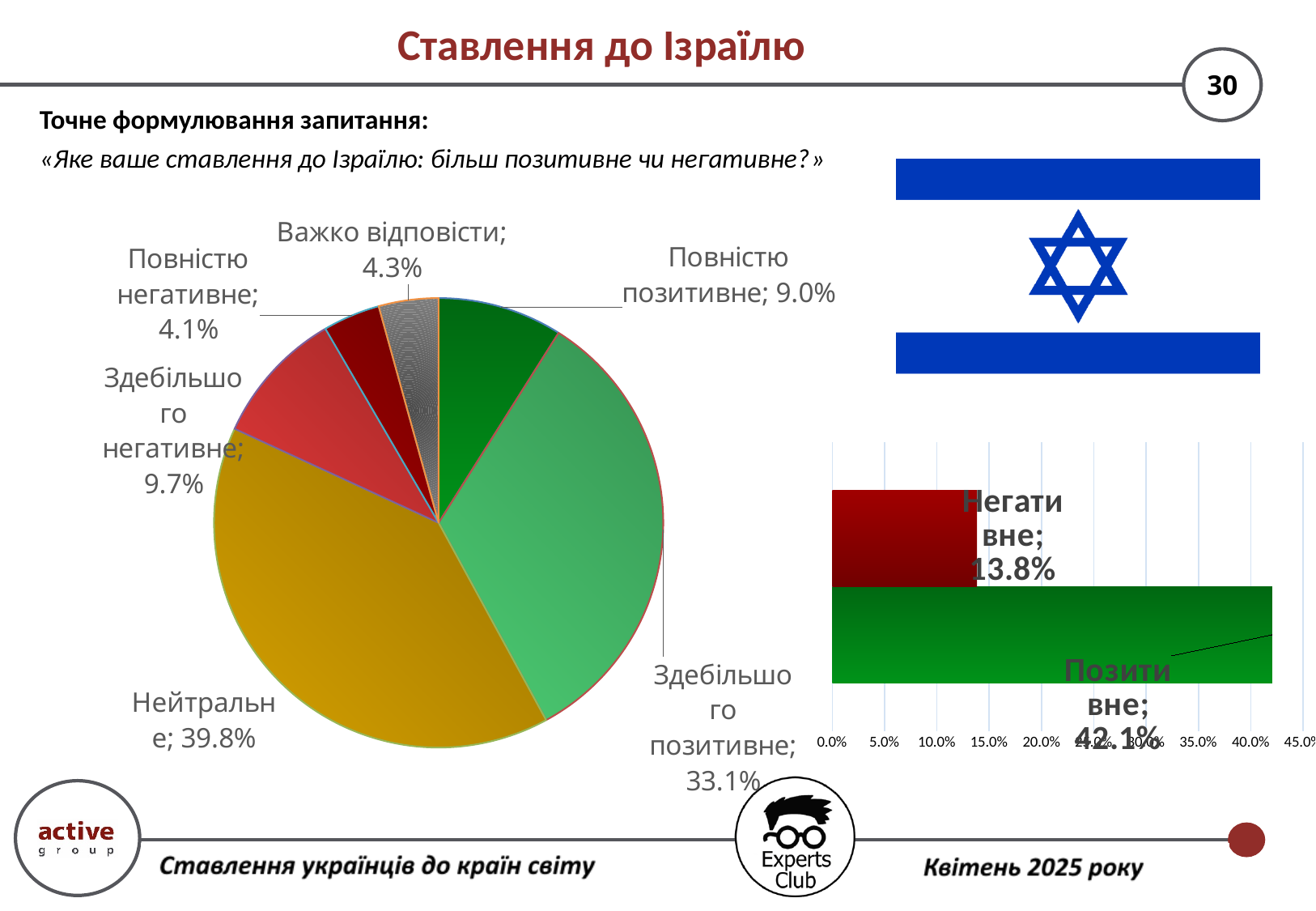
What kind of chart is shown on the right side of the slide below the flag? Bar chart In the pie chart, which category has the largest slice? Нейтральне In the pie chart, which category has the smallest slice? Повністю негативне In the pie chart, what share is labelled for "Здебільшого позитивне"? 33.1% In the pie chart, what is the difference between "Здебільшого позитивне" and "Здебільшого негативне"? 23.4% In the pie chart, what share is labelled for "Нейтральне"? 39.8% In the bar chart on the right, what is the value for "Позитивне"? 42.1% In the pie chart, how many slices are there? 6 In the bar chart on the right, what is the value for "Негативне"? 13.8% In the bar chart on the right, what is the difference between "Позитивне" and "Негативне"? 28.3% In the pie chart, what share is labelled for "Повністю негативне"? 4.1% In the pie chart, which is larger: "Повністю позитивне" or "Здебільшого негативне"? Здебільшого негативне